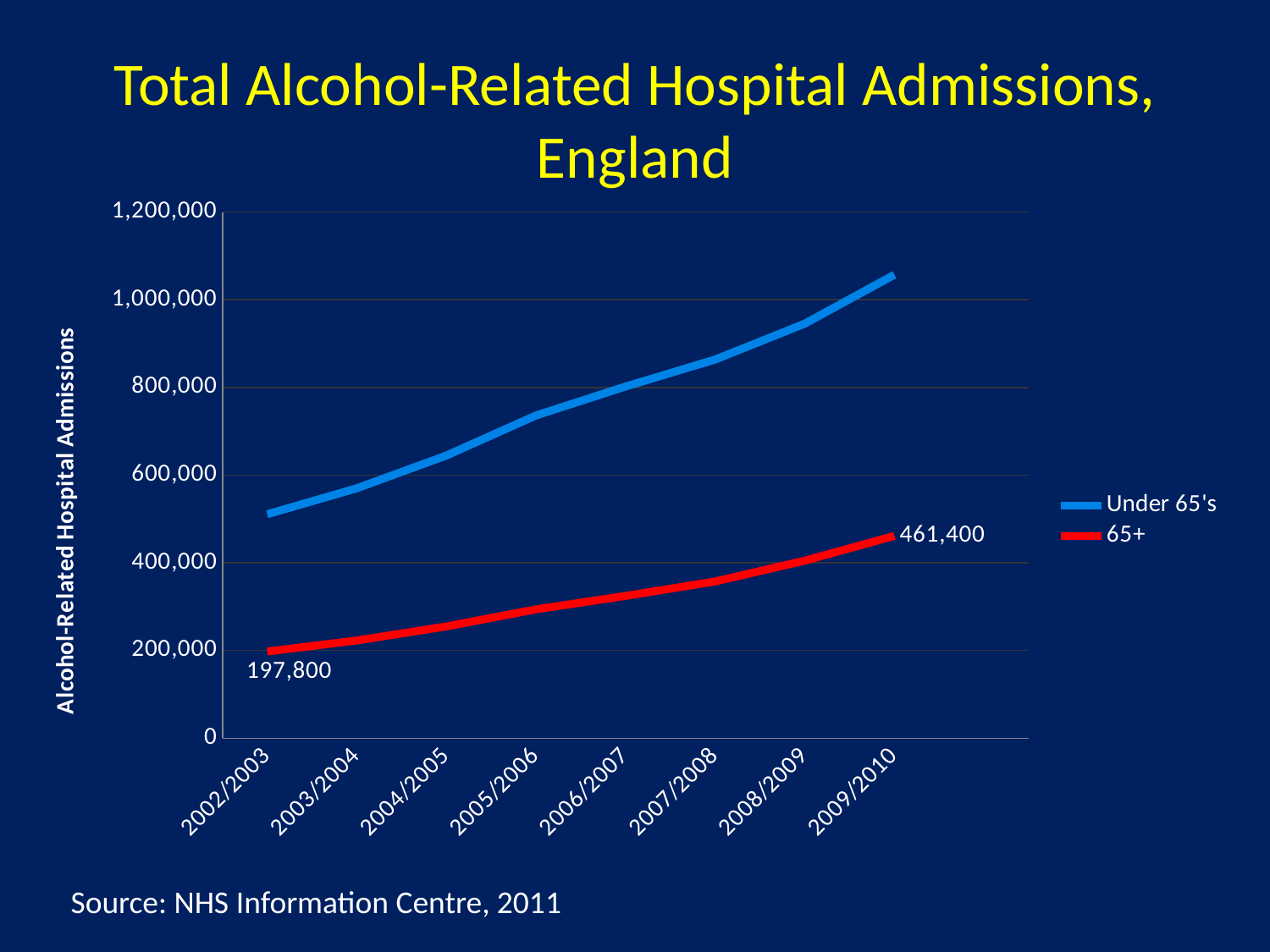
Is the value for Under 65's in 2002/2003 greater or less than 600,000? less How many series does the legend list? 2 What is the difference between the 65+ values in 2009/2010 and 2002/2003? 263,600 How many years are shown on the x axis? 8 What is the value for the 65+ series in 2009/2010? 461,400 What kind of chart is shown on the slide? line chart What is the value for the 65+ series in 2002/2003? 197,800 Do the Under 65's values rise or fall from 2002/2003 to 2009/2010? rise Which series is higher in 2009/2010, Under 65's or 65+? Under 65's Is the value for 65+ in 2005/2006 greater or less than 400,000? less Is the value for Under 65's in 2009/2010 greater or less than 1,000,000? greater What is the title of the chart? Total Alcohol-Related Hospital Admissions, England